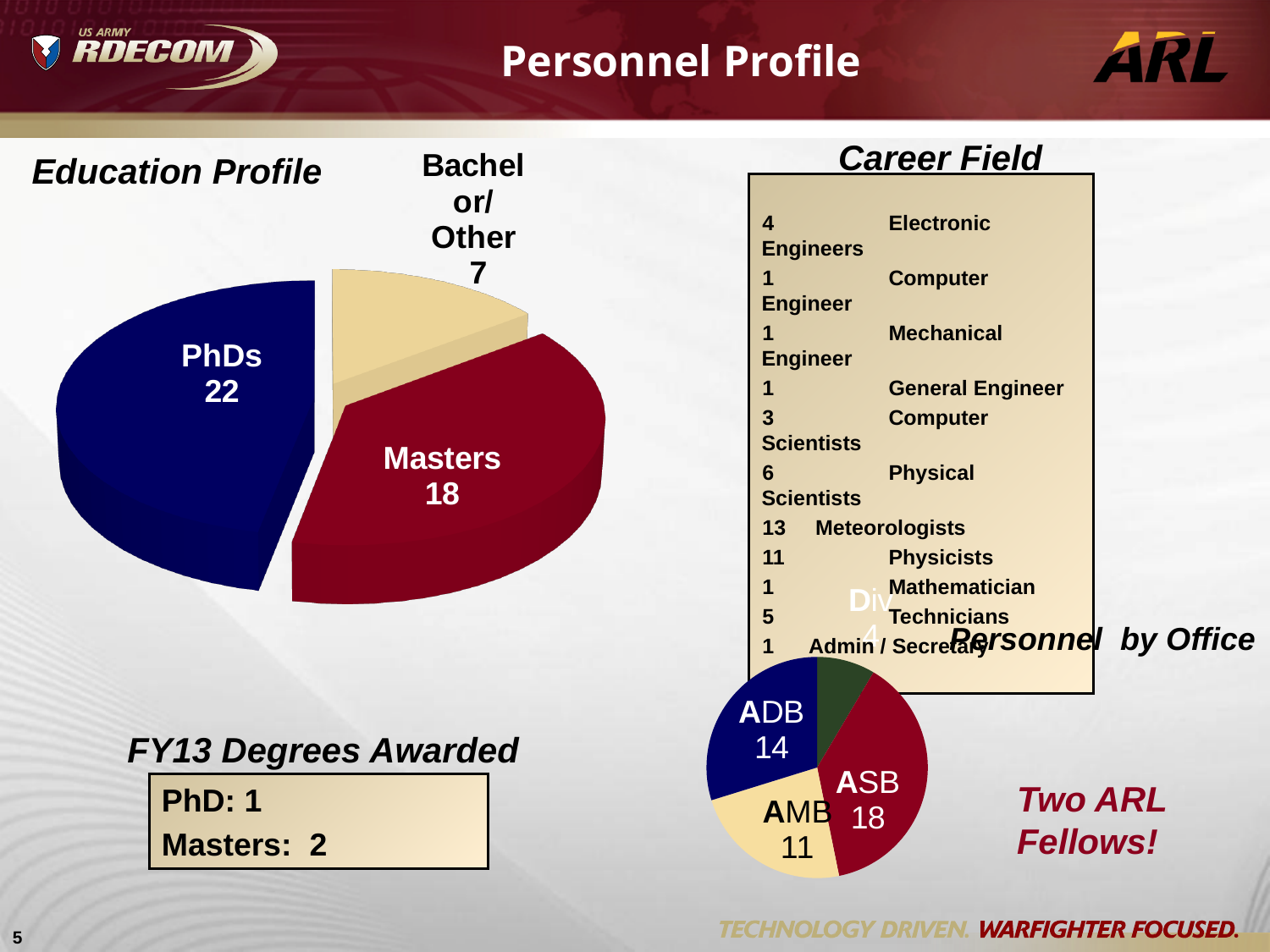
In the Education Profile chart, which category has the smallest slice? Bachelor/Other In the Personnel by Office chart, what is the value for ASB? 18 In the Education Profile chart, what is the difference between the number of PhDs and the number of Masters? 4 In the Education Profile chart, how many personnel hold Masters degrees? 18 What type of chart is the Education Profile chart? Pie chart In the Personnel by Office chart, what is the value for ADB? 14 In the Education Profile chart, how many personnel hold PhDs? 22 In the Education Profile chart, what is the value for Bachelor/Other? 7 In the Education Profile chart, what is the total of all three categories? 47 In the Personnel by Office chart, what is the difference between ADB and AMB? 3 In the Education Profile chart, which category has the largest slice? PhDs In the Personnel by Office chart, which is larger, AMB or ASB? ASB